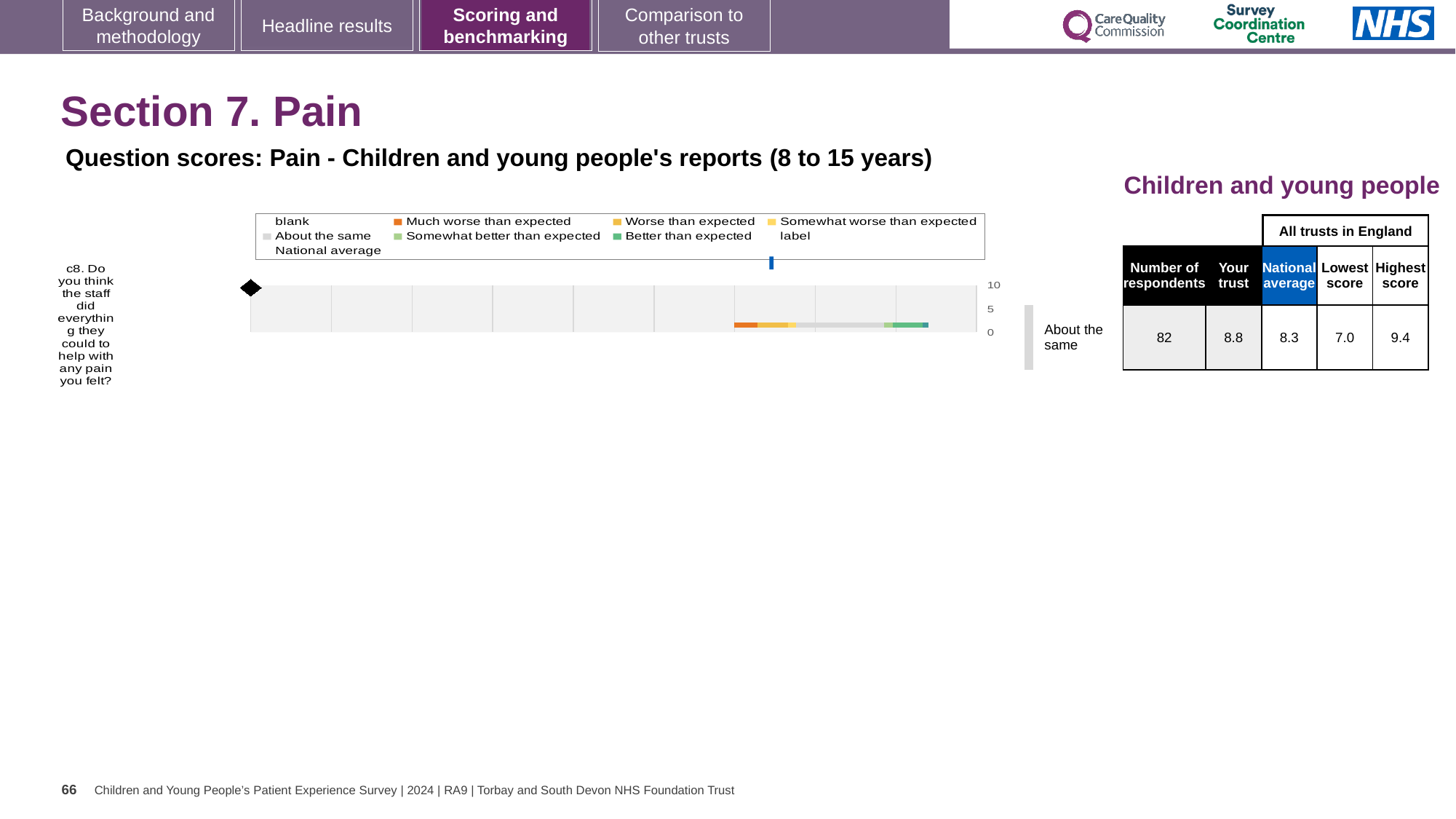
In the table beside the chart, what is the Highest score among all trusts in England for question c8? 9.4 How many survey questions are plotted in the chart? 1 For question c8, what is the difference between the Highest score and the Lowest score among all trusts in England? 2.4 For question c8, which is higher: the 'Your trust' score or the National average? Your trust In the table beside the chart, what is the National average score for question c8? 8.3 In the table beside the chart, how many respondents answered question c8? 82 In the table beside the chart, what is the 'Your trust' score for question c8? 8.8 Which survey question is plotted in the chart? c8. Do you think the staff did everything they could to help with any pain you felt? What benchmark category label is shown to the right of the chart for question c8? About the same For question c8, what is the difference between the 'Your trust' score and the National average? 0.5 What kind of chart is shown on the slide? bar chart In the table beside the chart, what is the Lowest score among all trusts in England for question c8? 7.0